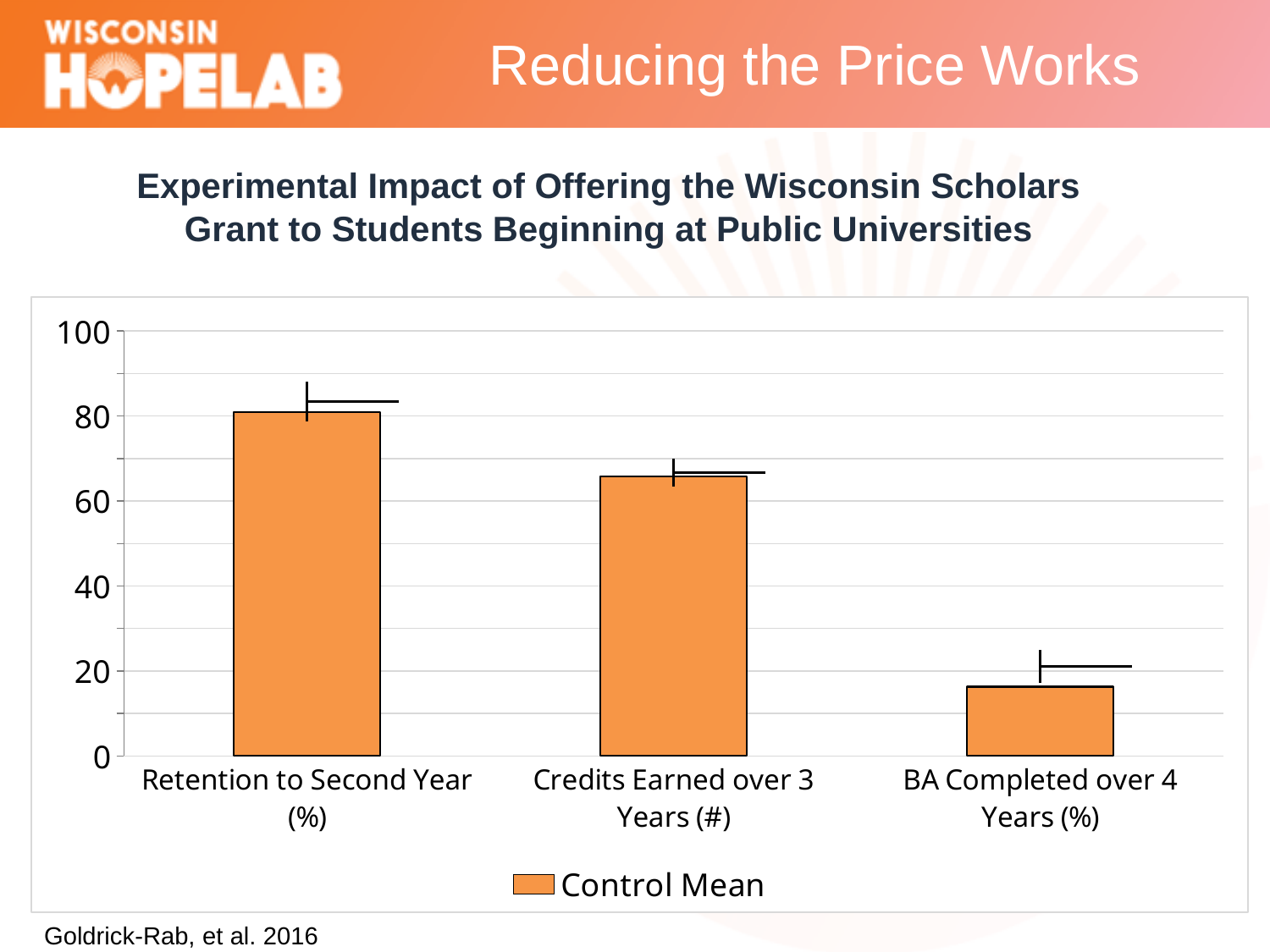
Do the Control Mean bars rise or fall from left to right along the x axis? fall Which is larger, the Control Mean bar for Credits Earned over 3 Years (#) or for BA Completed over 4 Years (%)? Credits Earned over 3 Years (#) What is the title printed above the chart? Experimental Impact of Offering the Wisconsin Scholars Grant to Students Beginning at Public Universities What is the name of the series shown in the chart's legend? Control Mean How many series does the chart's legend list? 1 Is the Control Mean value for BA Completed over 4 Years (%) greater or less than 20? less Is the Control Mean value for Credits Earned over 3 Years (#) greater or less than 60? greater What kind of chart is shown on the slide? bar chart How many categories are plotted on the x axis of the chart? 3 Which category has the lowest Control Mean bar? BA Completed over 4 Years (%) Which category has the highest Control Mean bar? Retention to Second Year (%)